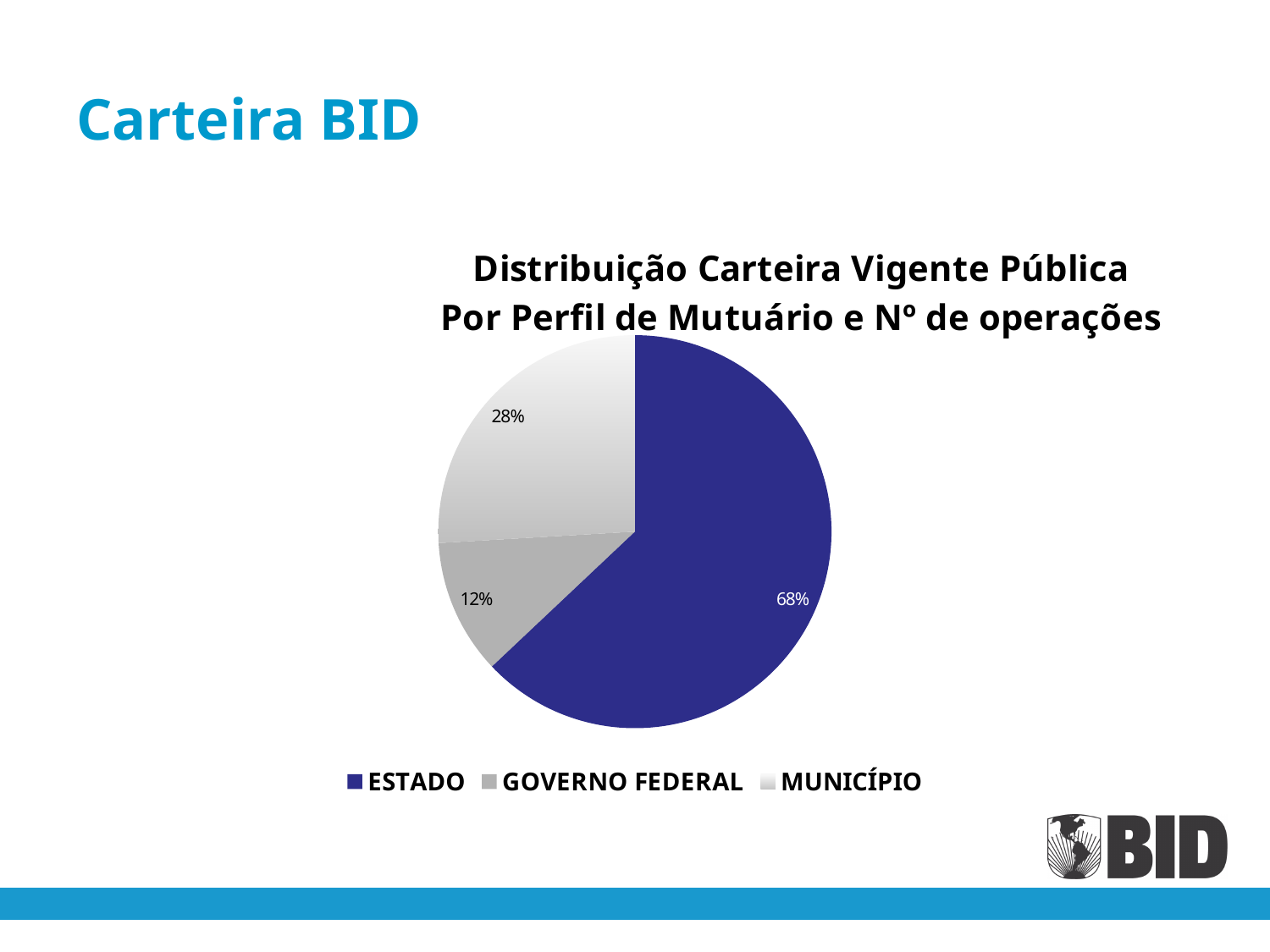
Which slice is larger, MUNICÍPIO or GOVERNO FEDERAL? MUNICÍPIO What share of the pie does MUNICÍPIO hold? 28% What share of the pie does ESTADO hold? 68% What share of the pie does GOVERNO FEDERAL hold? 12% What is the title of the chart? Distribuição Carteira Vigente Pública Por Perfil de Mutuário e Nº de operações How many categories does the pie chart show? 3 Which category has the smallest slice of the pie? GOVERNO FEDERAL What is the difference in percentage points between the ESTADO and MUNICÍPIO slices? 40 Which category is shown in dark blue in the pie chart? ESTADO What is the difference in percentage points between the MUNICÍPIO and GOVERNO FEDERAL slices? 16 Which category has the largest slice of the pie? ESTADO What kind of chart is shown on the slide? Pie chart